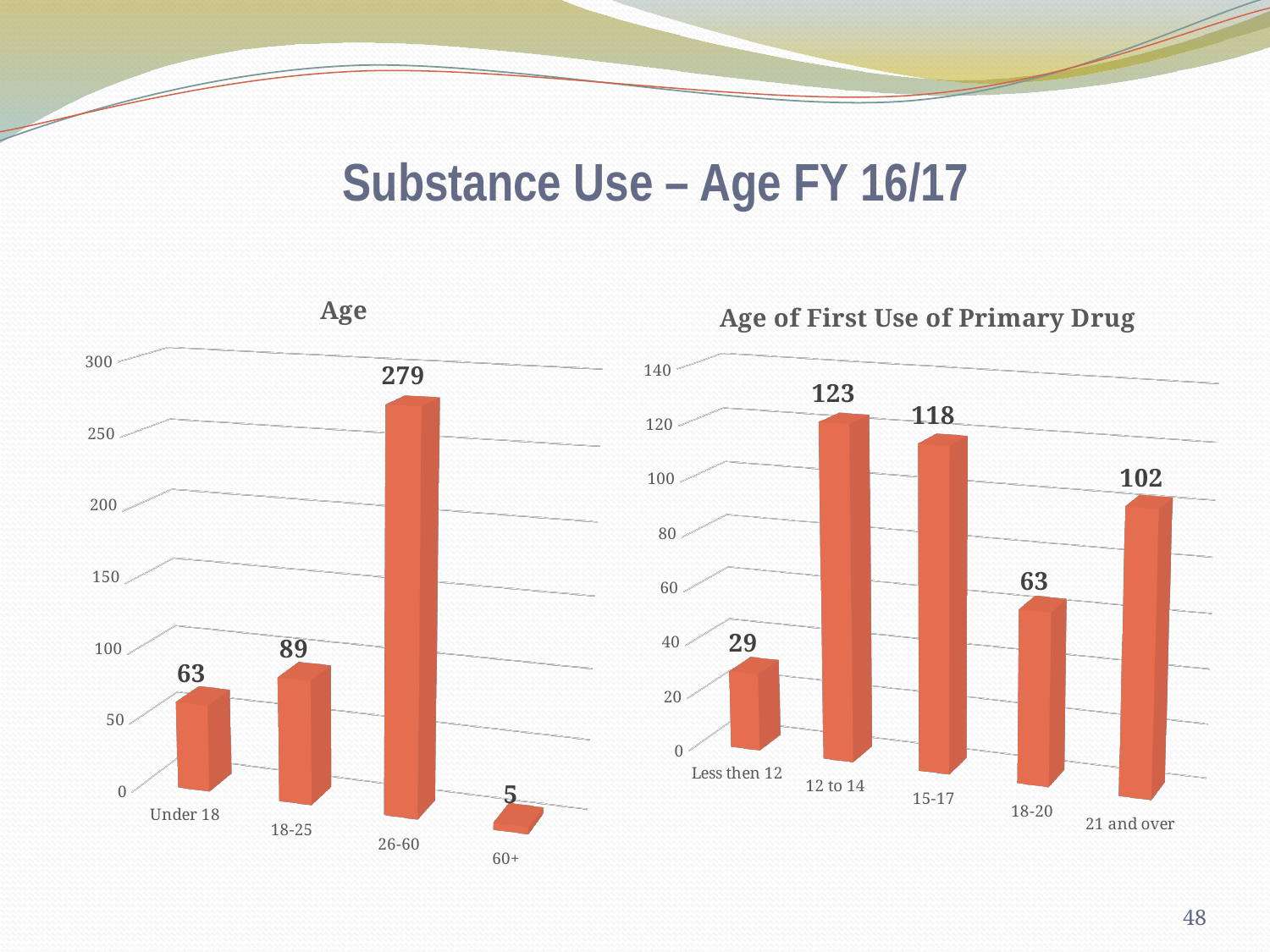
In the "Age of First Use of Primary Drug" chart, how many categories are shown? 5 In the "Age" chart, which age group has the lowest value? 60+ In the "Age" chart, what is the difference between the values for 18-25 and Under 18? 26 In the "Age" chart, what is the value for 26-60? 279 In the "Age of First Use of Primary Drug" chart, which category has the highest value? 12 to 14 In the "Age of First Use of Primary Drug" chart, which is larger, the value for 18-20 or the value for 21 and over? 21 and over In the "Age" chart, is the value for 26-60 greater or less than 250? greater In the "Age of First Use of Primary Drug" chart, what is the difference between the values for 12 to 14 and 15-17? 5 In the "Age of First Use of Primary Drug" chart, what is the value for 15-17? 118 In the "Age of First Use of Primary Drug" chart, which category has the lowest value? Less then 12 What kind of chart is the "Age" chart on the left? Bar chart In the "Age" chart, how many age categories are shown? 4